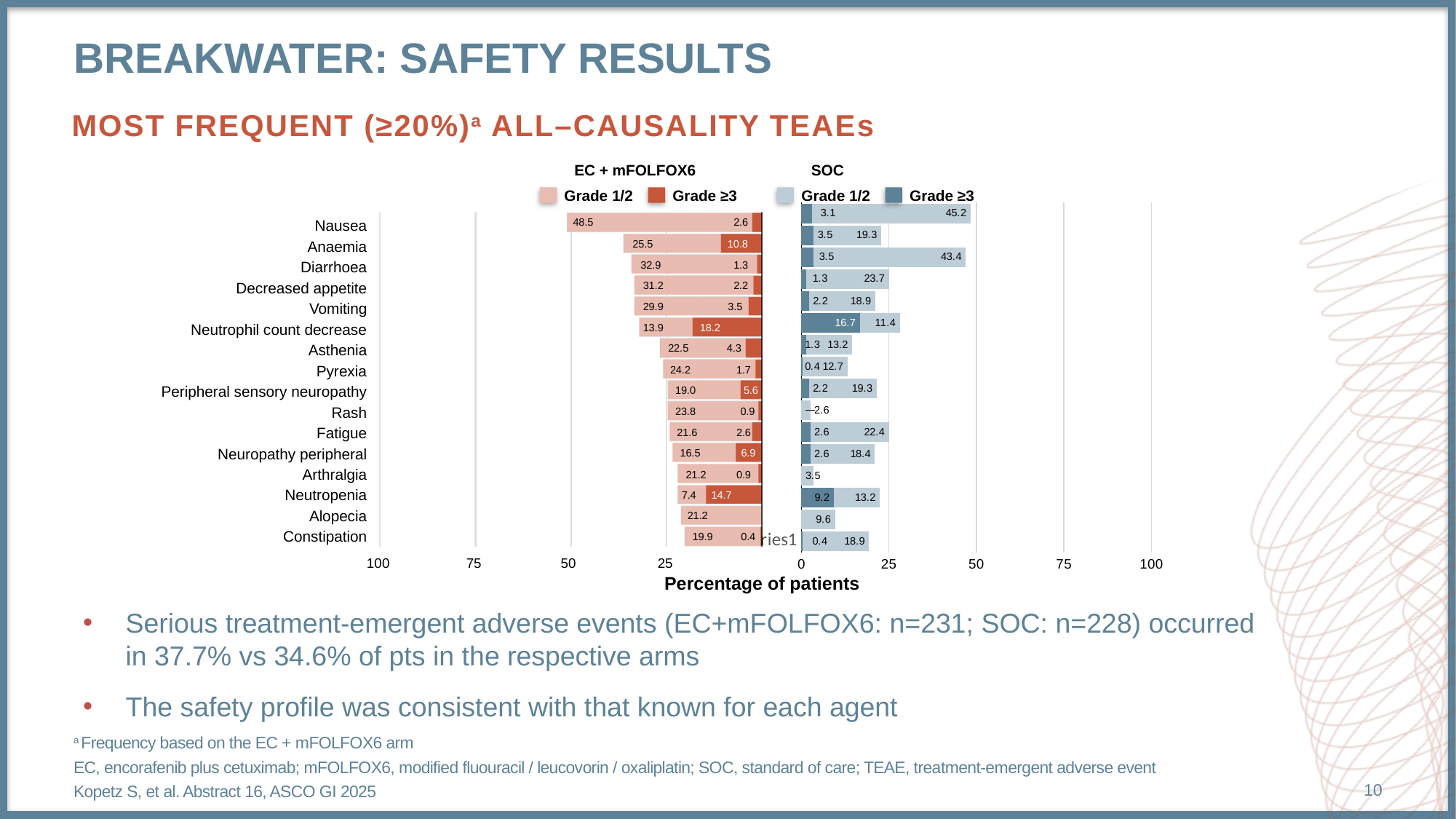
In the EC + mFOLFOX6 arm, which adverse event has the highest Grade ≥3 percentage? Neutrophil count decrease In the SOC arm, what is the Grade ≥3 percentage for Neutrophil count decrease? 16.7 What is the difference between the Grade 1/2 percentage for Nausea in the EC + mFOLFOX6 arm and in the SOC arm? 3.3 What is the combined Grade 1/2 and Grade ≥3 percentage for Neutrophil count decrease in the EC + mFOLFOX6 arm? 32.1 Which arm has the larger Grade ≥3 percentage for Anaemia, EC + mFOLFOX6 or SOC? EC + mFOLFOX6 What kind of chart is shown on the slide? Bar chart In the SOC arm, what is the Grade 1/2 percentage for Diarrhoea? 43.4 What is the label of the x axis? Percentage of patients In the EC + mFOLFOX6 arm, which adverse event has the highest Grade 1/2 percentage? Nausea In the EC + mFOLFOX6 arm, what is the Grade ≥3 percentage for Neutropenia? 14.7 How many adverse event categories are listed on the chart? 16 In the EC + mFOLFOX6 arm, what is the Grade 1/2 percentage for Nausea? 48.5